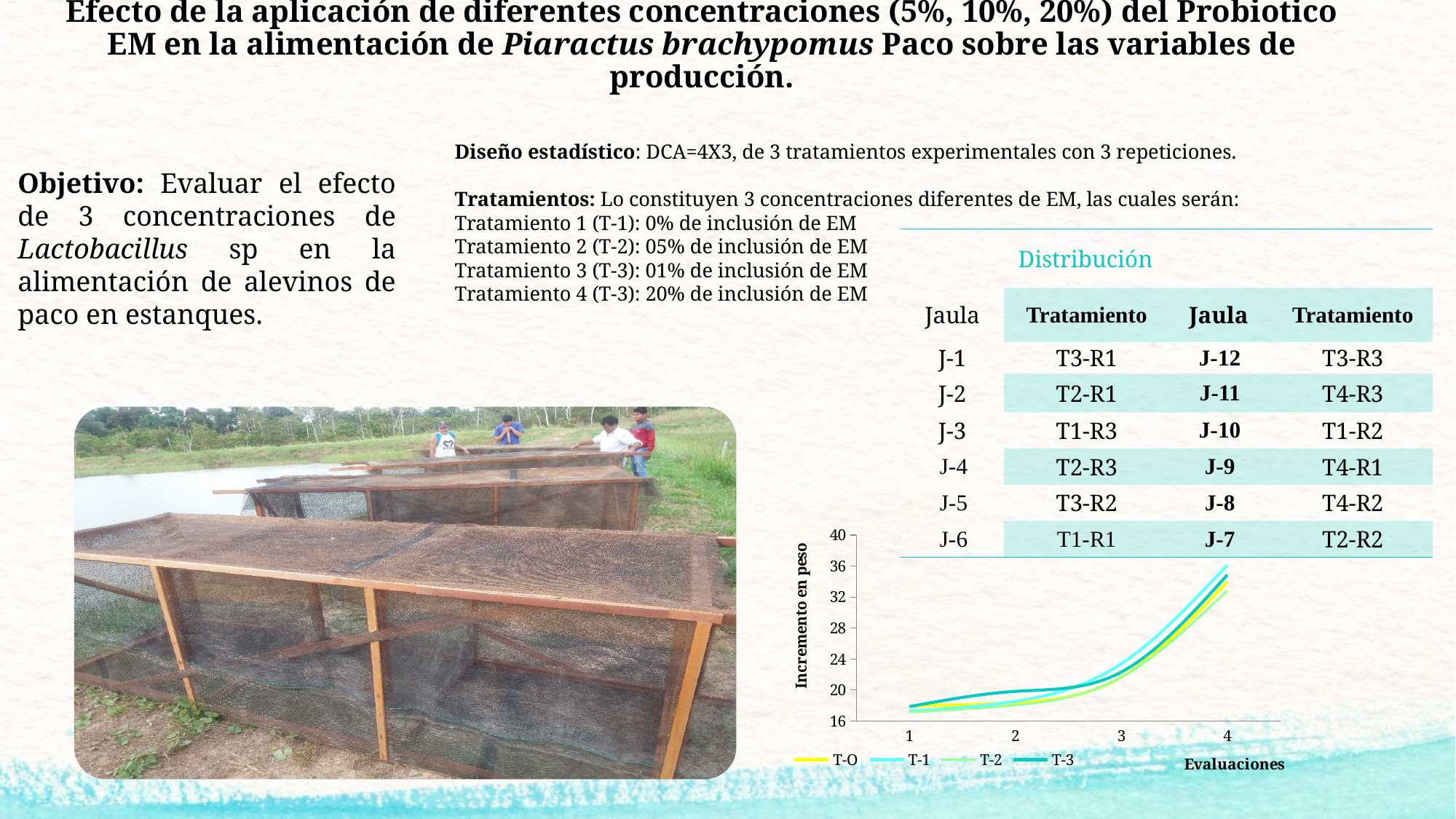
In the line chart, is the value for T-2 at evaluation 2 greater or less than 24? less Do the values in the line chart rise or fall from evaluation 1 to evaluation 4? rise In the line chart, is the value for T-O at evaluation 4 greater or less than 28? greater What is the label of the y axis of the line chart? Incremento en peso How many series does the legend of the line chart list? 4 In the line chart, is the value for T-3 at evaluation 4 greater or less than 28? greater What is the label of the x axis of the line chart? Evaluaciones What kind of chart is shown at the bottom right of the slide? line chart How many evaluation points are plotted along the x axis of the line chart? 4